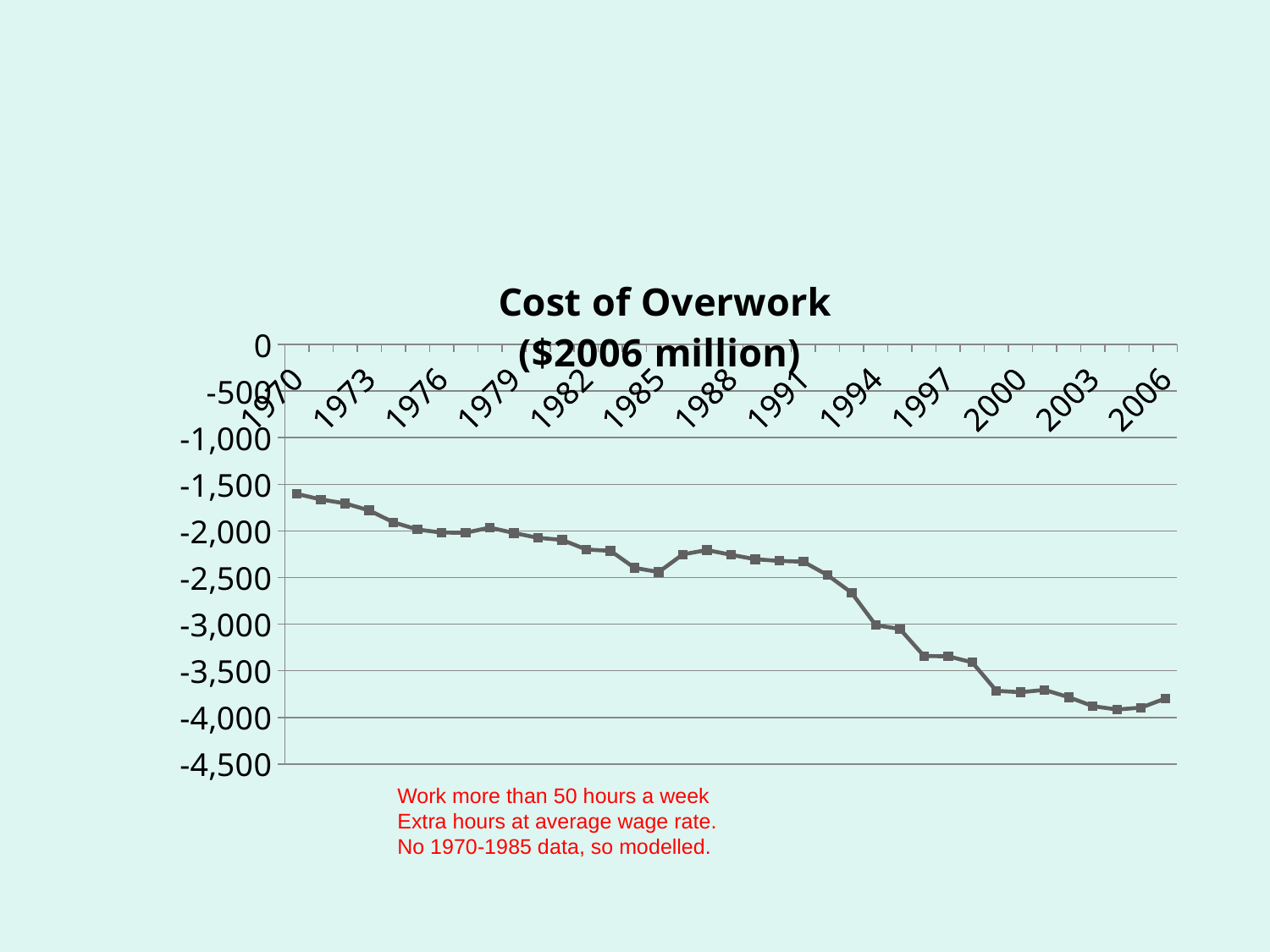
Is the value for 1988 greater or less than -2,500? greater Is the value for 2006 greater or less than -4,000? greater Which has the larger value, 1970 or 2006? 1970 What kind of chart is shown on the slide? line chart What is the title of the chart? Cost of Overwork ($2006 million) Is the value for 1994 greater or less than -2,500? less How many year labels are shown on the x axis? 13 Overall, do the values rise or fall from 1970 to 2006? fall Which year has the highest (least negative) value on the chart? 1970 Which has the larger value, 1985 or 1988? 1988